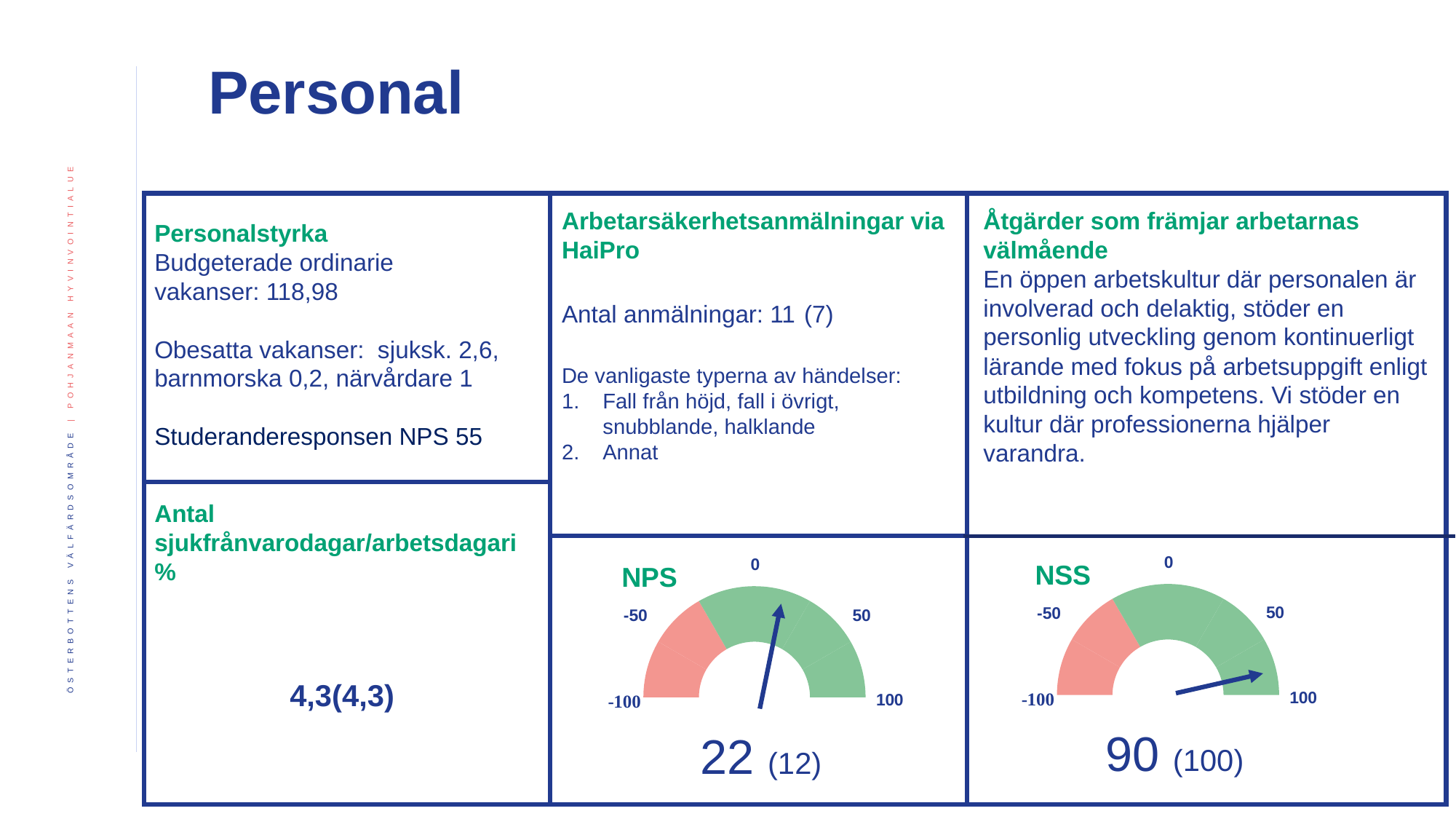
On the NPS gauge chart, what is the difference between the main value and the value in parentheses? 10 On the NPS gauge chart, what value is shown? 22 On the NSS gauge chart, is the needle value greater or less than 50? greater On the NPS gauge chart, what value is shown in parentheses next to the main value? 12 On the NSS gauge chart, what value is shown in parentheses next to the main value? 100 What are the lowest and highest tick labels on the NPS gauge chart? -100 and 100 On the NSS gauge chart, what value is shown? 90 What is the difference between the main value on the NSS gauge chart and the main value on the NPS gauge chart? 68 Which gauge chart shows the higher main value, NPS or NSS? NSS On the NSS gauge chart, what is the difference between the value in parentheses and the main value? 10 What kind of chart is used for NPS and NSS on the slide? Gauge chart On the NPS gauge chart, is the needle value greater or less than 50? less